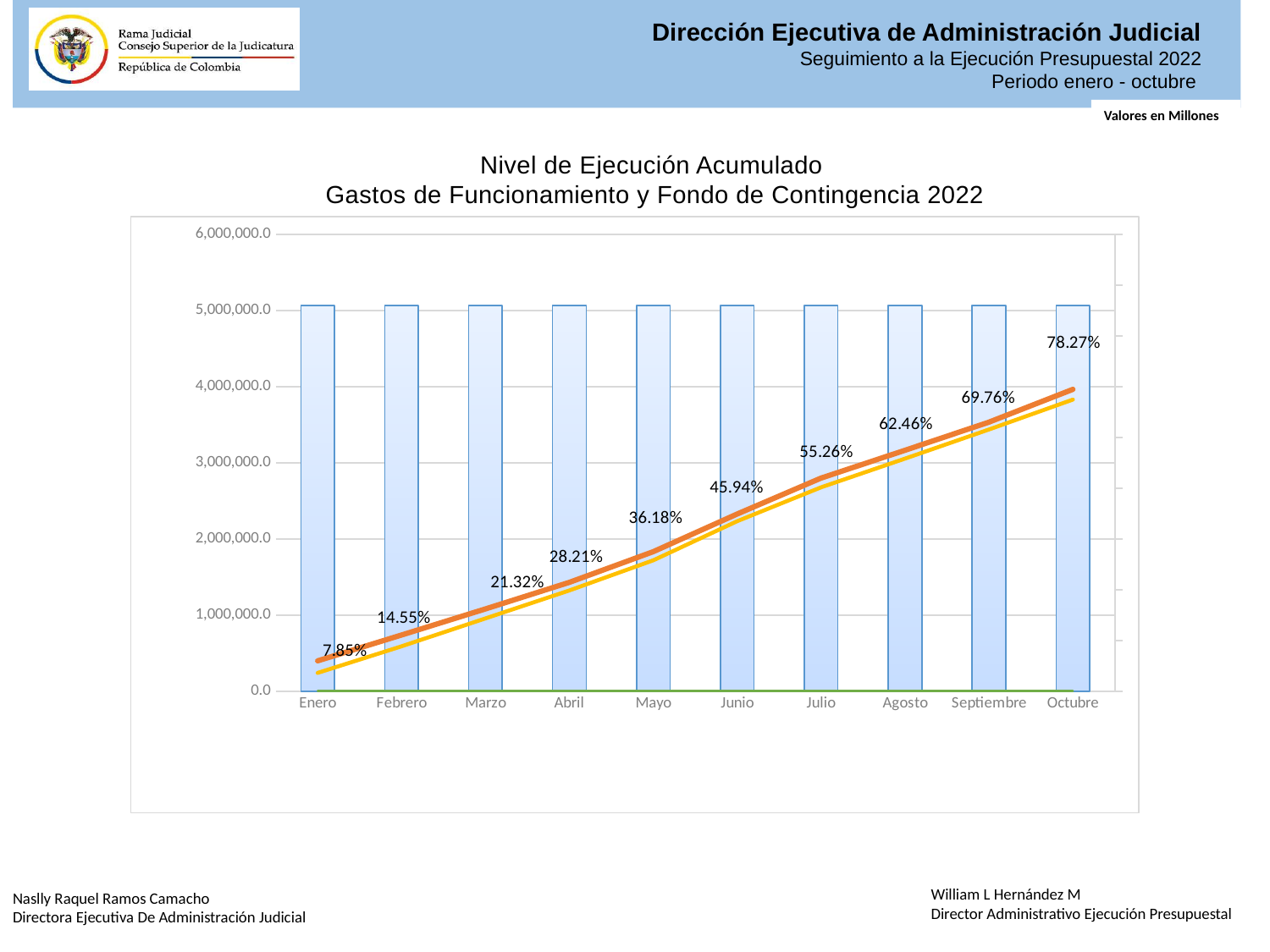
Which is larger, the percentage label for Julio or for Mayo? Julio What is the difference between the percentage labels for Octubre and Enero? 70.42% What percentage label is shown for Octubre? 78.27% Do the line values rise or fall from Enero to Octubre? rise What percentage label is shown for Enero? 7.85% Is the value of the orange line at Enero greater or less than 1,000,000.0? less Is the value of the bar for Enero greater or less than 4,000,000.0? greater Which month has the lowest percentage label? Enero What percentage label is shown for Junio? 45.94% How many months are shown on the x axis? 10 What percentage label is shown for Abril? 28.21% Which month has the highest percentage label? Octubre